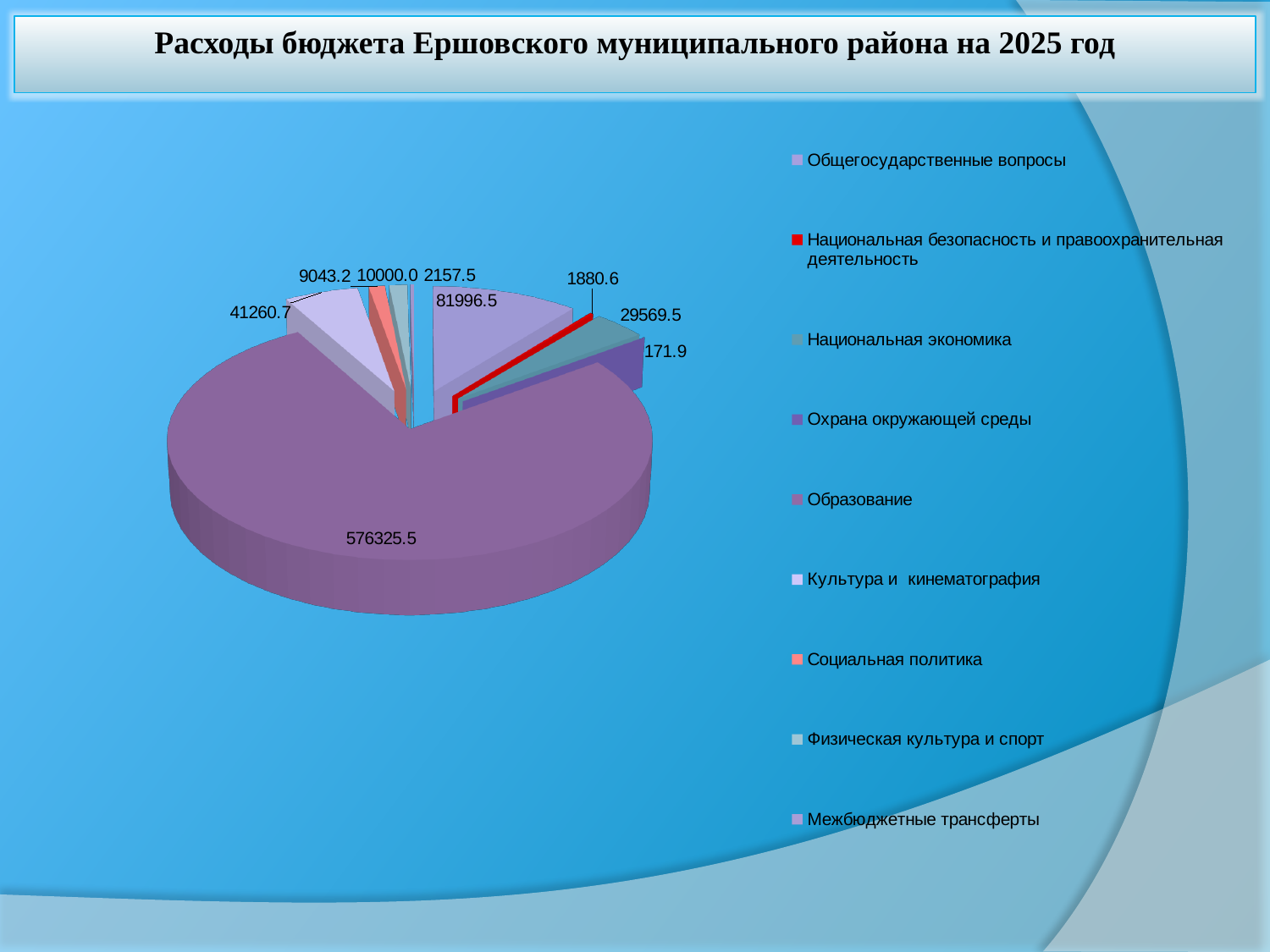
What is the value shown for Охрана окружающей среды? 171.9 Which category has the smallest slice of the pie chart? Охрана окружающей среды What is the value shown for Общегосударственные вопросы? 81996.5 What is the difference between the values for Общегосударственные вопросы and Национальная экономика? 52427.0 Which category has the largest slice of the pie chart? Образование What is the value shown for Образование? 576325.5 What kind of chart is shown on the slide? Pie chart How many categories does the legend of the pie chart list? 9 What is the value shown for Национальная экономика? 29569.5 What is the title of the chart on the slide? Расходы бюджета Ершовского муниципального района на 2025 год What is the value shown for Культура и кинематография? 41260.7 Which is larger, the value for Общегосударственные вопросы or the value for Национальная экономика? Общегосударственные вопросы